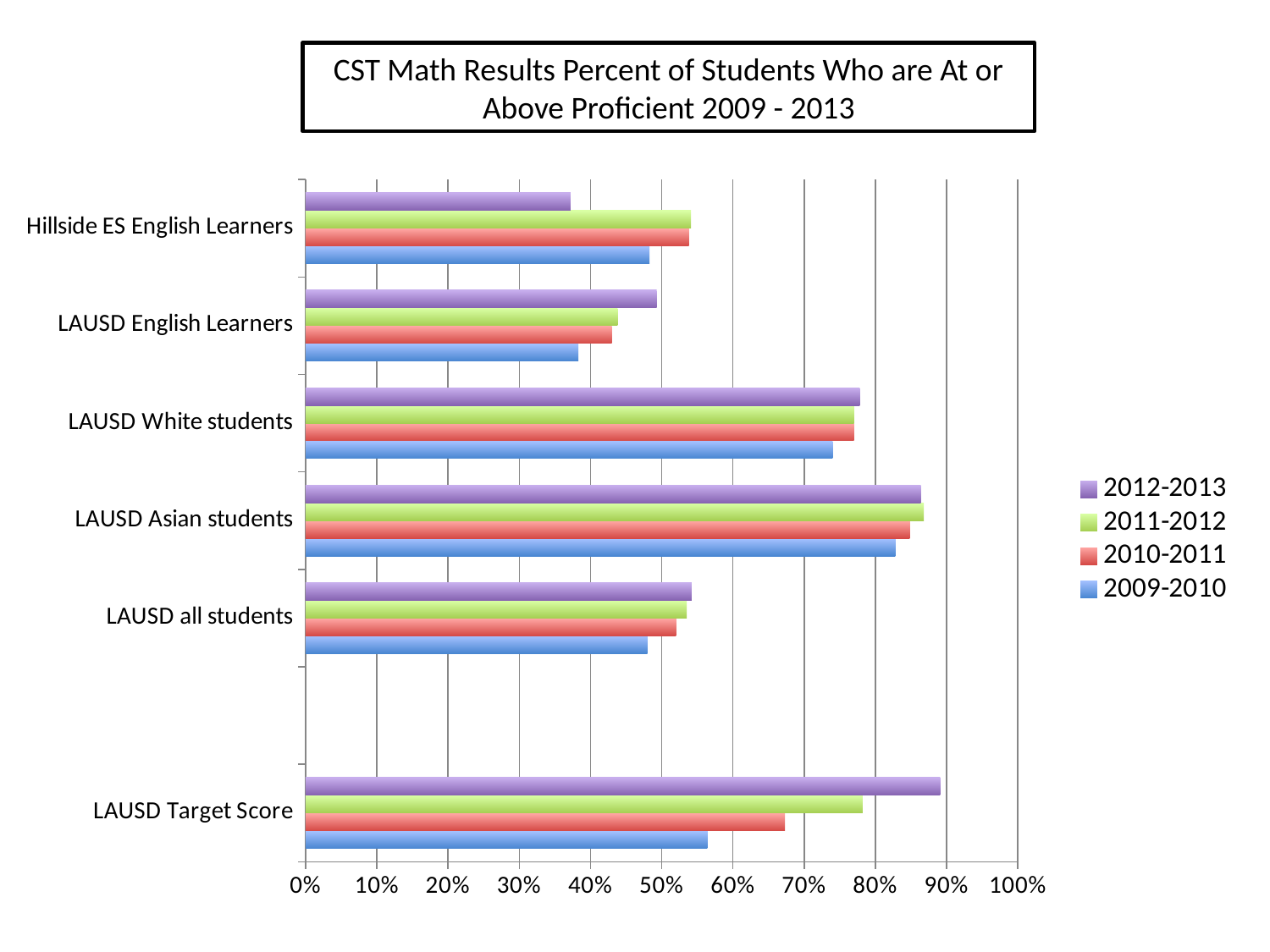
Is the 2009-2010 value for LAUSD Asian students greater or less than 80%? greater What is the title of the chart? CST Math Results Percent of Students Who are At or Above Proficient 2009 - 2013 For 2012-2013, which is larger: Hillside ES English Learners or LAUSD English Learners? LAUSD English Learners Does the LAUSD Target Score rise or fall from 2009-2010 to 2012-2013? rise Is the 2012-2013 value for LAUSD Target Score greater or less than 80%? greater Which category has the lowest 2012-2013 value? Hillside ES English Learners What kind of chart is shown on the slide? bar chart Is the 2009-2010 value for LAUSD English Learners greater or less than 40%? less How many series does the legend list? 4 Which colour represents the 2012-2013 series in the legend? purple